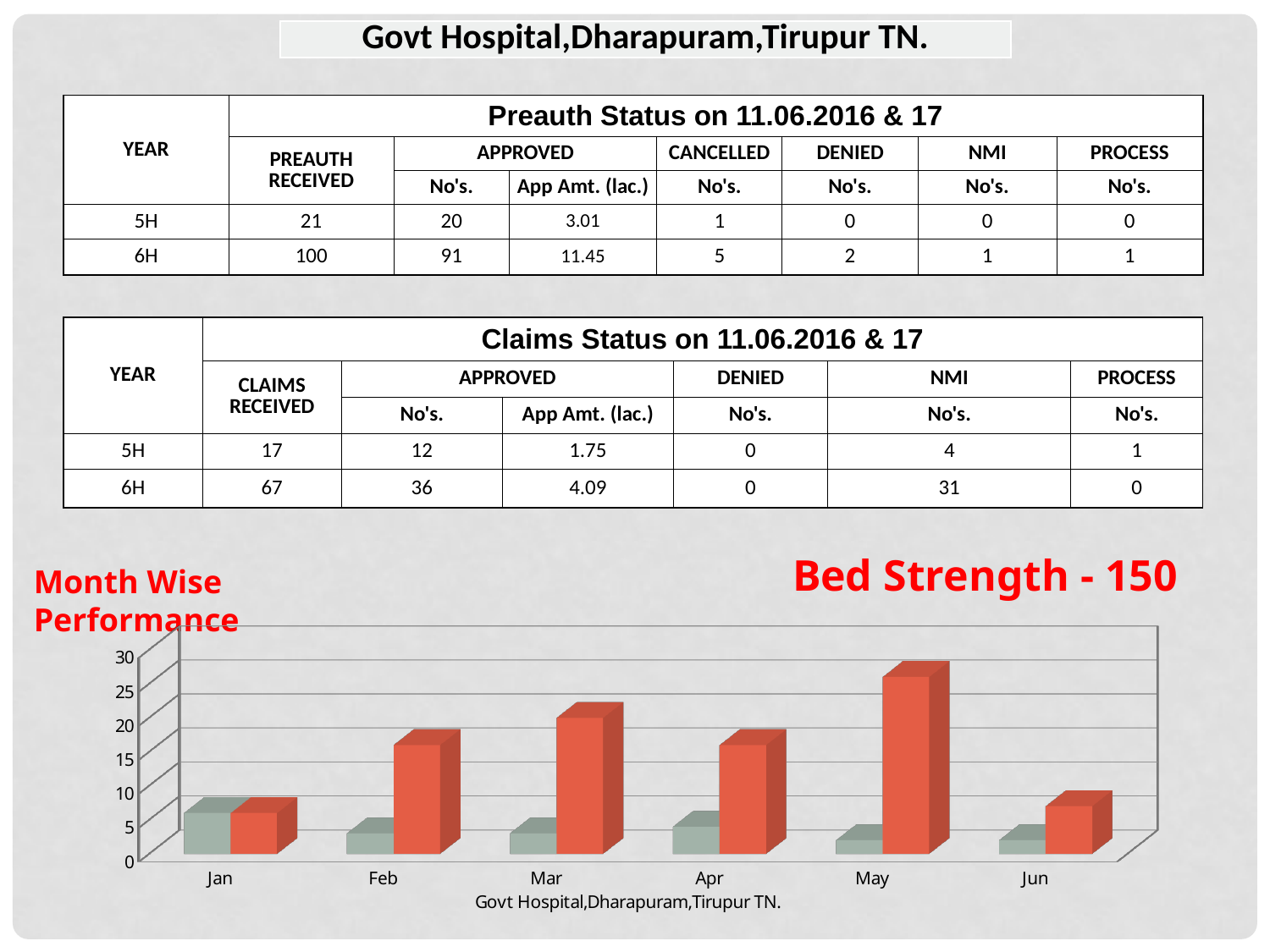
What text appears as the chart's title below the x axis? Govt Hospital,Dharapuram,Tirupur TN. Which month has the larger red-series value, Mar or Feb? Mar Does the red series rise or fall from Jan to Mar? rise Is the value of the red series for May greater or less than 20? greater In which month is the red (taller) series highest? May In which month is the grey series highest? Jan Is the value of the red series for Jan greater or less than 10? less Which month has the larger grey-series value, Jan or May? Jan What kind of chart is shown under the 'Month Wise Performance' heading? bar chart How many months are shown on the x axis of the bar chart? 6 Is the value of the red series for Mar greater or less than 15? greater